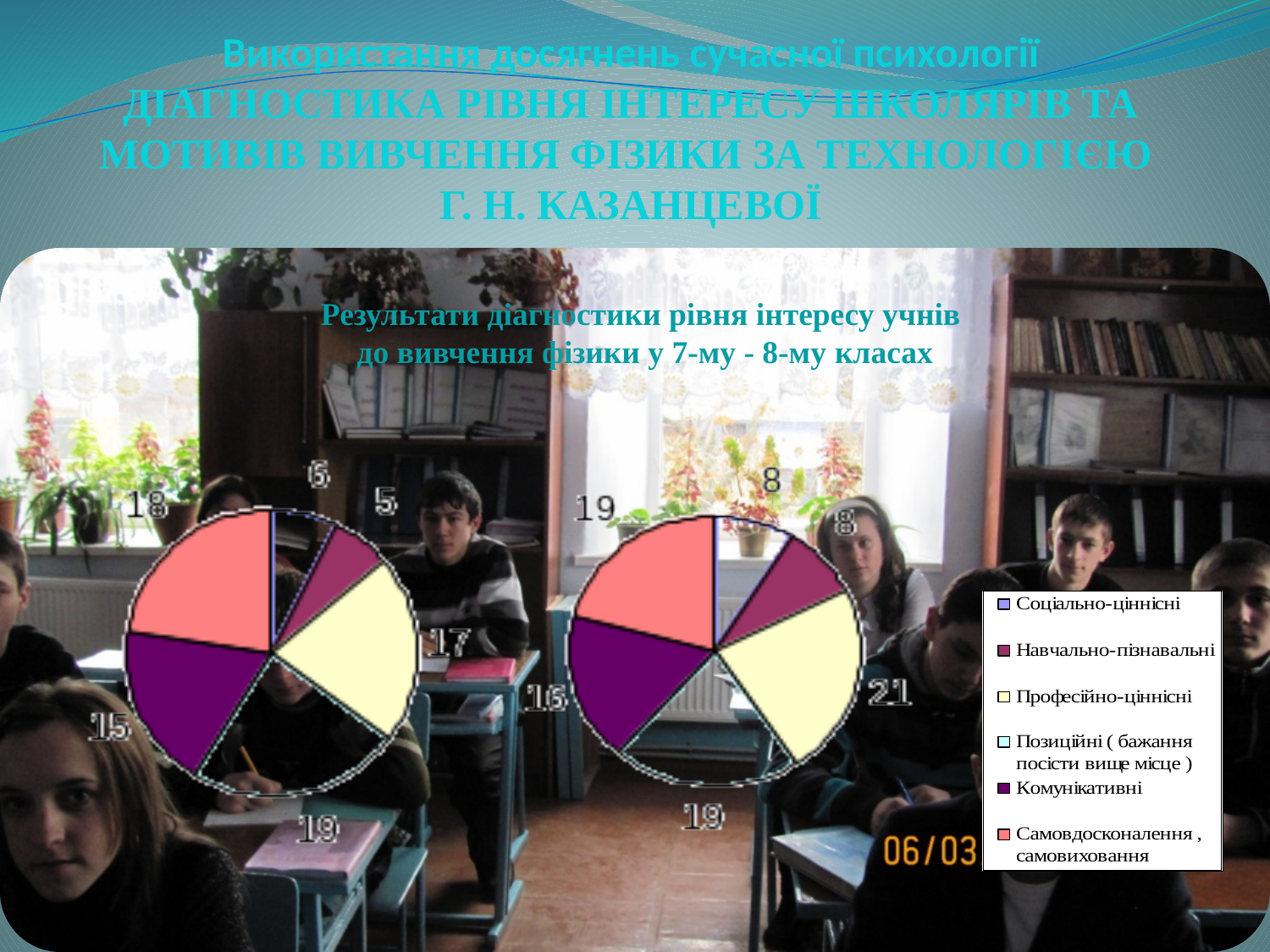
In the right pie chart, what is the value of the Професійно-ціннісні (yellow) slice? 21 In the left pie chart, what is the value of the Навчально-пізнавальні (magenta) slice? 5 In the right pie chart, what is the difference between the Самовдосконалення, самовиховання slice (19) and the Соціально-ціннісні slice (8)? 11 Which colour represents Комунікативні in the legend? Purple What kind of charts are shown on the slide? Pie charts In the left pie chart, what is the value of the Соціально-ціннісні (blue) slice? 6 How many categories does the legend list? 6 How many pie charts are on the slide? 2 In the left pie chart, what is the value of the Самовдосконалення, самовиховання (pink) slice? 18 In the right pie chart, what is the value of the Соціально-ціннісні (blue) slice? 8 In the right pie chart, which category has the largest value? Професійно-ціннісні In the left pie chart, which category has the smallest value? Навчально-пізнавальні